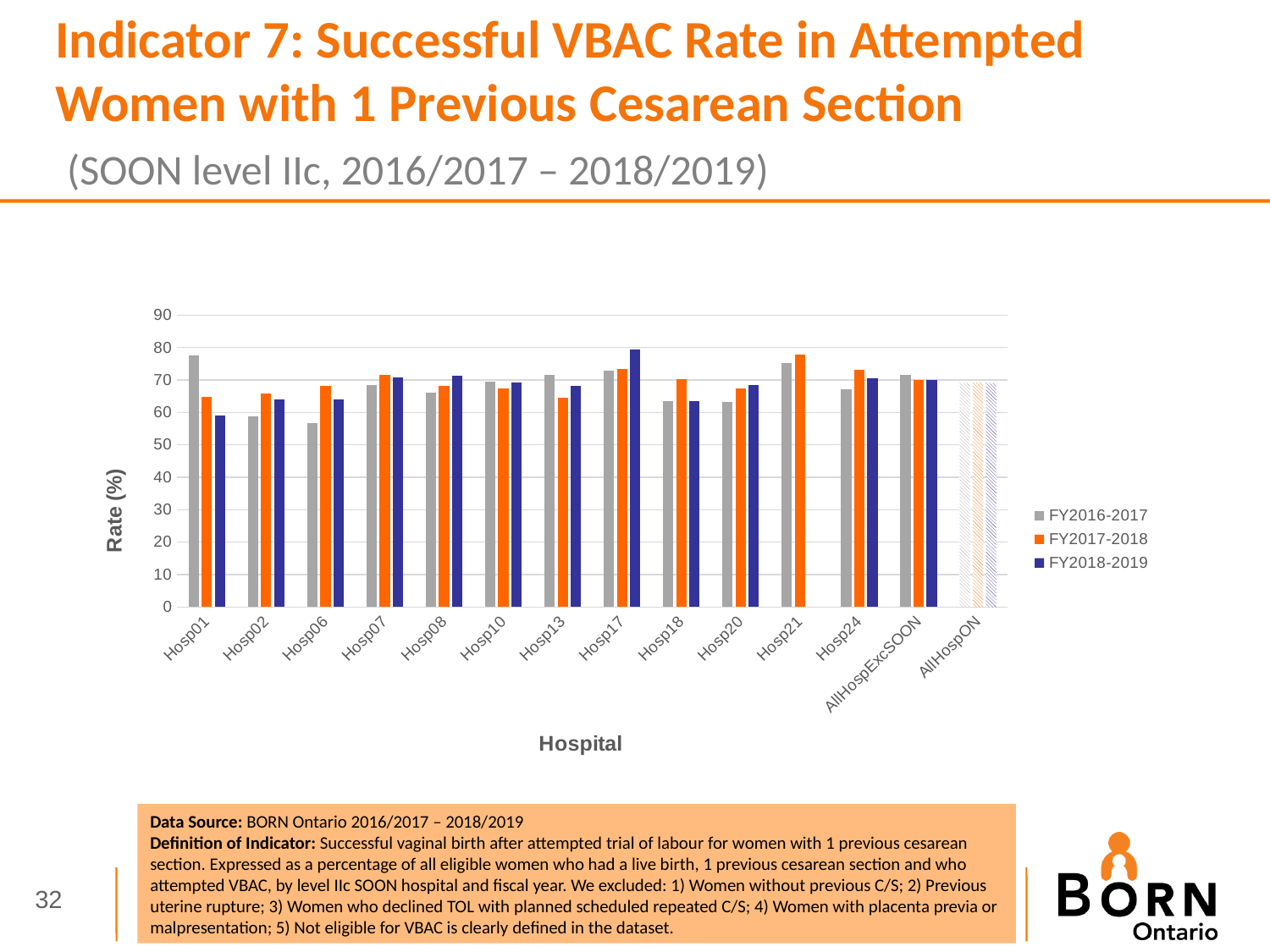
Is the FY2018-2019 value for Hosp17 greater or less than 70? greater What kind of chart is shown on the slide? Bar chart How many series does the legend list? 3 For Hosp01, which is larger: the FY2016-2017 value or the FY2018-2019 value? FY2016-2017 Which hospital has the highest FY2018-2019 value? Hosp17 What is the label of the y axis? Rate (%) Is the FY2016-2017 value for Hosp01 greater or less than 70? greater Which series is shown in orange in the legend? FY2017-2018 Is the FY2016-2017 value for Hosp06 greater or less than 60? less How many hospital categories are shown along the x axis? 14